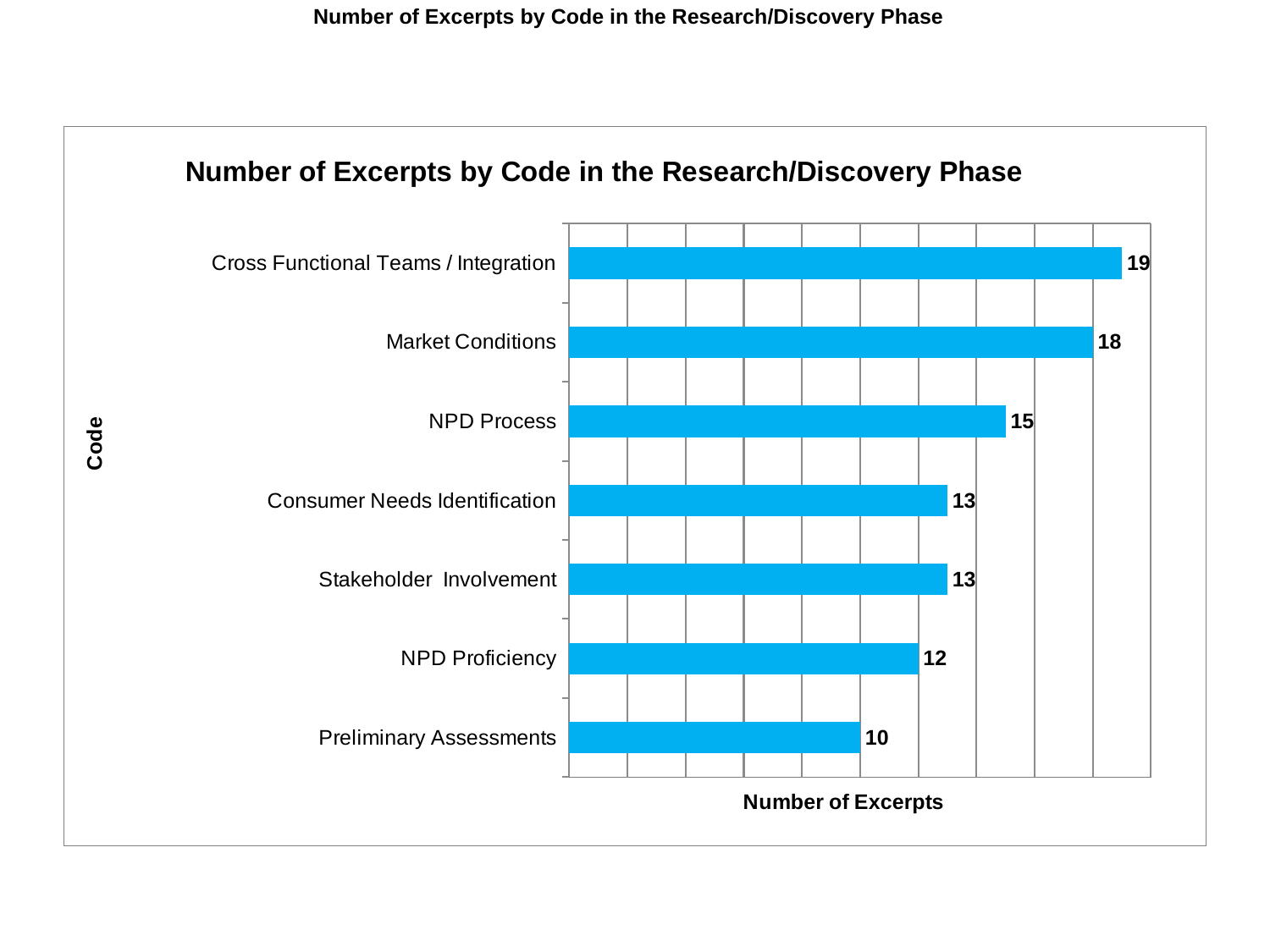
What is the number of excerpts for Market Conditions? 18 How many codes are shown in the chart? 7 What is the label of the horizontal axis? Number of Excerpts What is the title of the chart? Number of Excerpts by Code in the Research/Discovery Phase Which code has the highest number of excerpts? Cross Functional Teams / Integration What is the number of excerpts for NPD Proficiency? 12 What is the difference in number of excerpts between Cross Functional Teams / Integration and Preliminary Assessments? 9 What kind of chart is shown on the slide? Bar chart What is the difference in number of excerpts between NPD Process and NPD Proficiency? 3 Which code has the lowest number of excerpts? Preliminary Assessments Which has more excerpts, Market Conditions or NPD Process? Market Conditions What is the number of excerpts for Consumer Needs Identification? 13